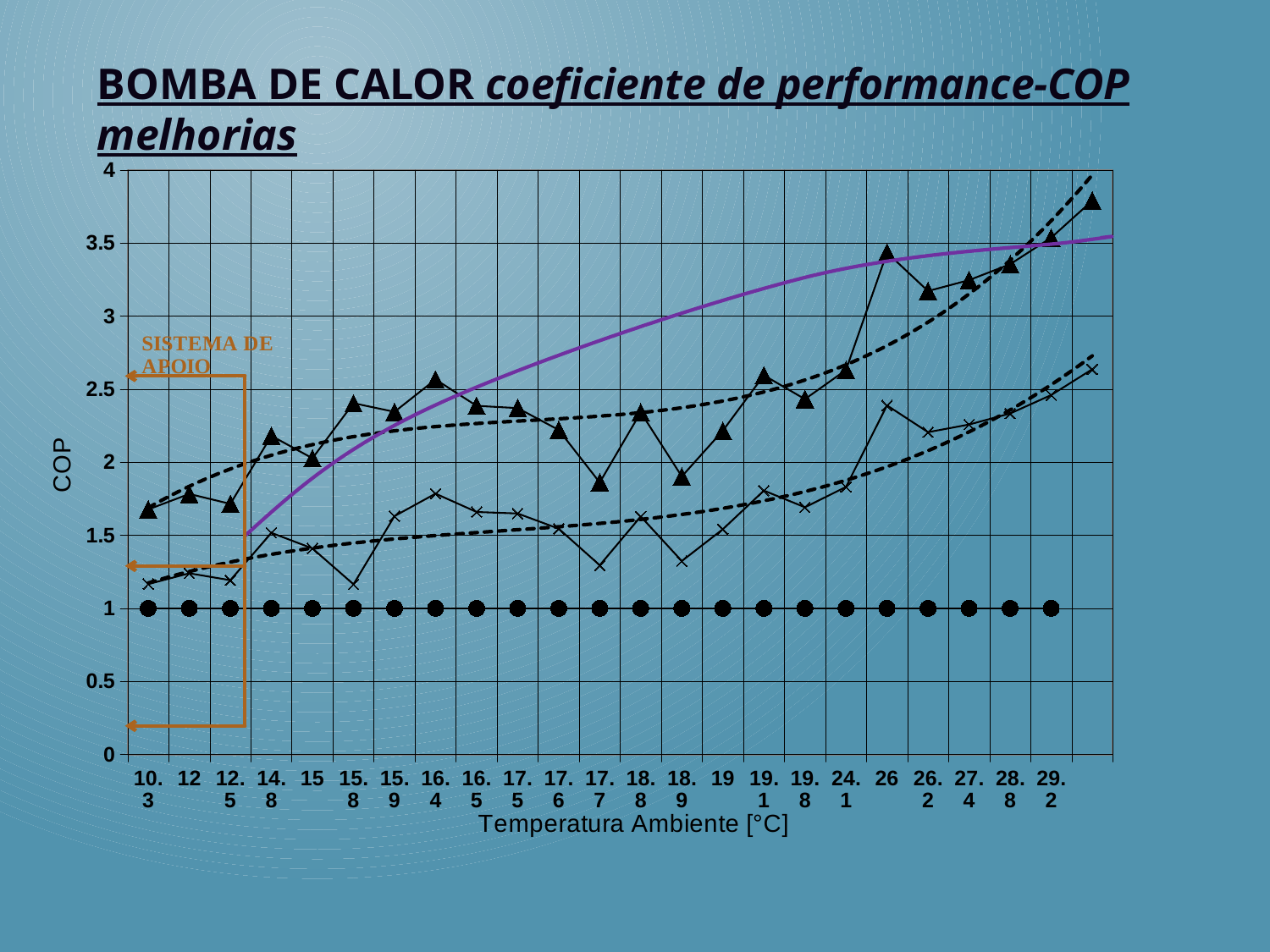
What is the COP value of the series with circle markers at 19 °C? 1 What kind of chart is shown on the slide? line chart What is the title of the x axis of the chart? Temperatura Ambiente [°C] Is the COP of the cross-marker series at 17.7 °C greater or less than 1.5? less Overall, does the COP of the triangle-marker series rise or fall as the ambient temperature increases along the x axis? rise Is the COP of the triangle-marker series at 26 °C greater or less than 3? greater How many temperature categories are shown on the x axis? 23 What is the title of the y axis of the chart? COP Is the COP of the triangle-marker series at 17.7 °C greater or less than 2? less Which is larger for the triangle-marker series: the COP at 16.4 °C or at 17.7 °C? 16.4 °C